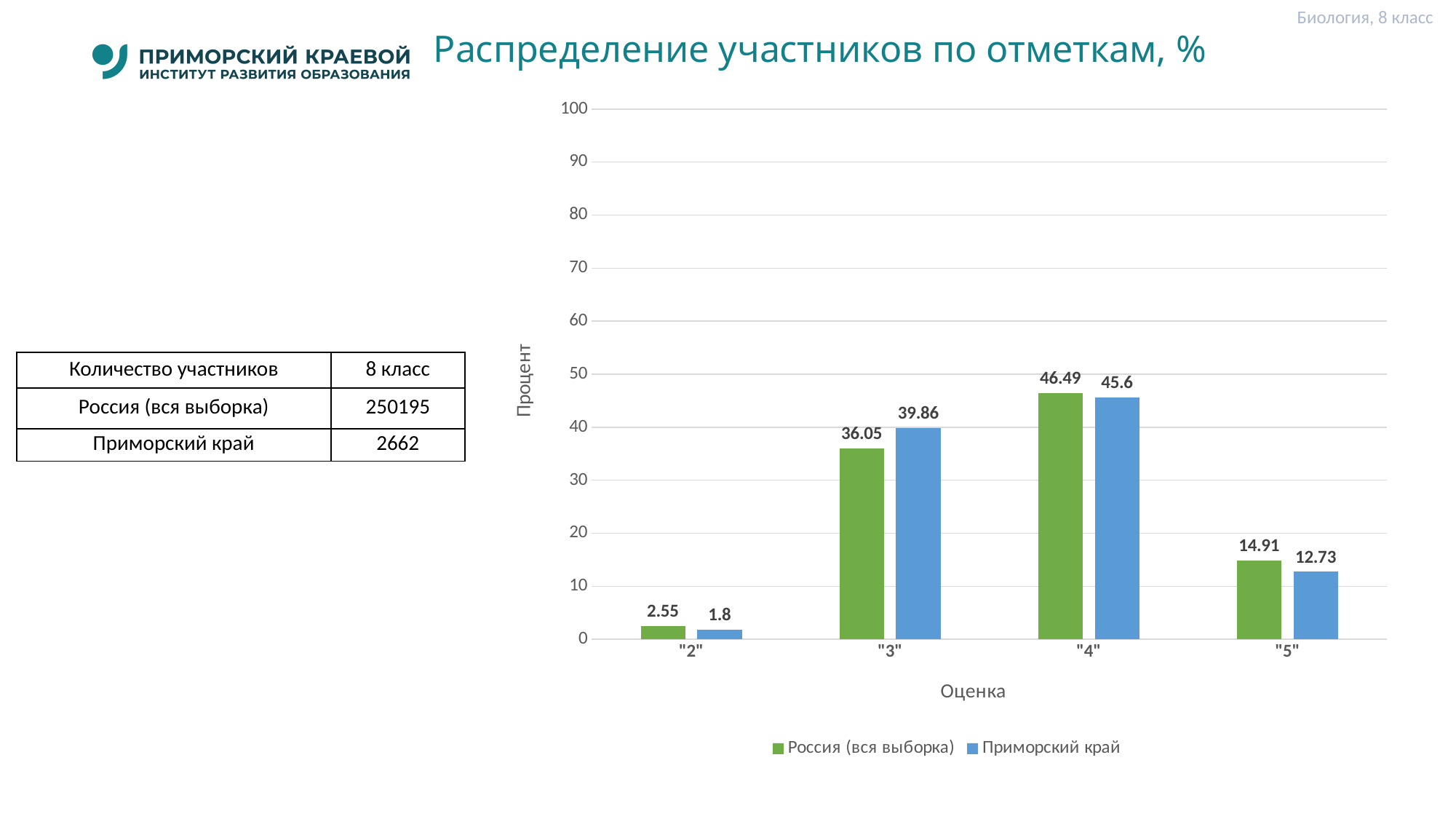
What is the value for Приморский край at grade "4"? 45.6 At grade "5", which series has the larger value: Россия (вся выборка) or Приморский край? Россия (вся выборка) What is the value for Приморский край at grade "2"? 1.8 Which grade has the lowest value for Россия (вся выборка)? "2" What is the value for Россия (вся выборка) at grade "3"? 36.05 What is the difference between Россия (вся выборка) and Приморский край at grade "3"? 3.81 What is the title of the chart? Распределение участников по отметкам, % How many grade categories are shown on the x axis? 4 How many series does the legend list? 2 Which grade has the highest value for Приморский край? "4" What kind of chart is shown on the slide? bar chart What is the value for Россия (вся выборка) at grade "5"? 14.91